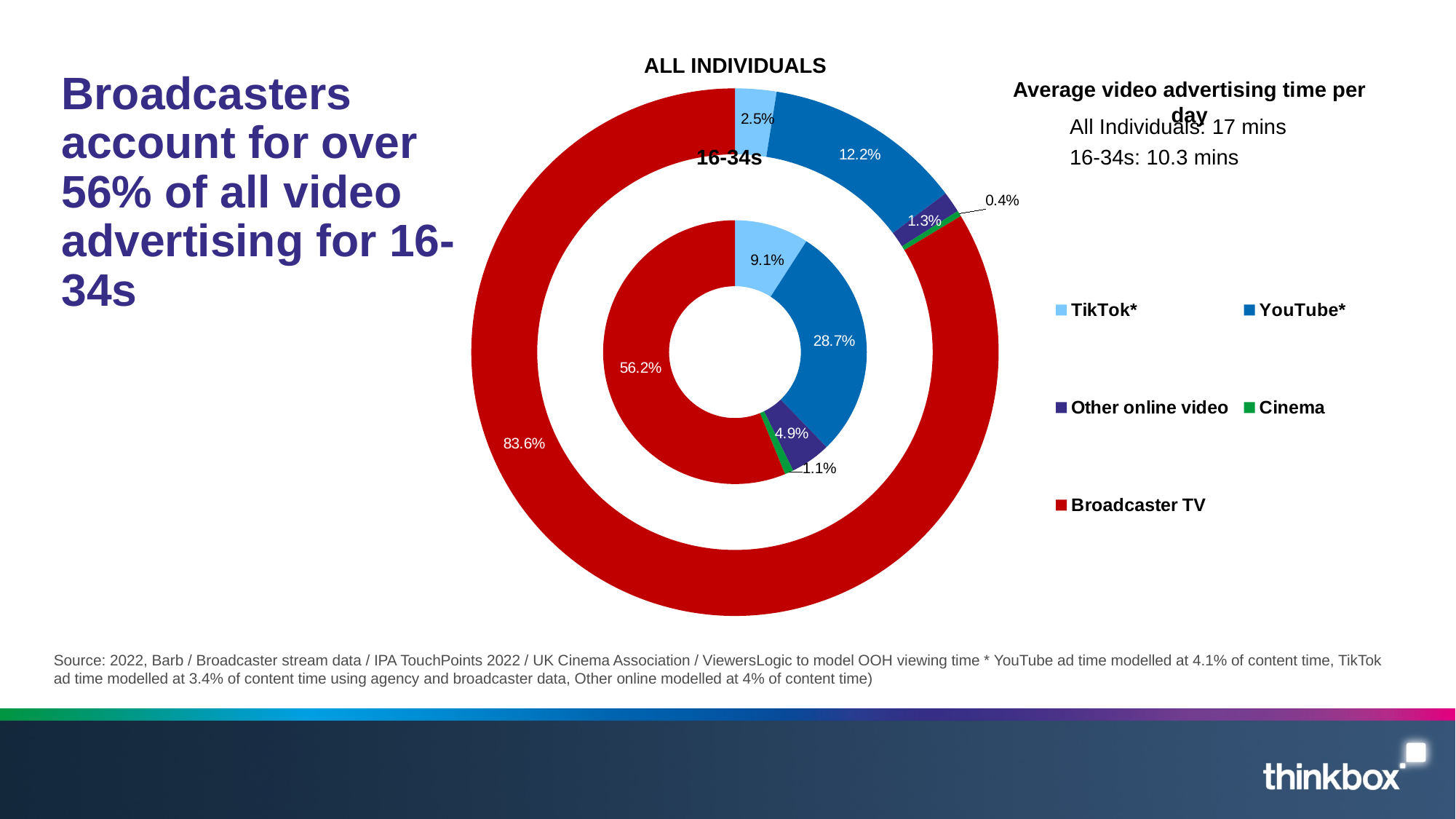
In the doughnut chart, what share does Other online video account for in the ALL INDIVIDUALS ring? 1.3% In the doughnut chart, what is the difference between the Broadcaster TV share for ALL INDIVIDUALS and for 16-34s? 27.4 percentage points In the doughnut chart, what share does YouTube* account for in the 16-34s ring? 28.7% In the doughnut chart, which category has the smallest share in the ALL INDIVIDUALS ring? Cinema In the doughnut chart, which category has the largest share in the 16-34s ring? Broadcaster TV In the doughnut chart, what share does Cinema account for in the 16-34s ring? 1.1% In the doughnut chart, what share does TikTok* account for in the ALL INDIVIDUALS ring? 2.5% What kind of chart is shown on the slide? Doughnut chart In the doughnut chart, what share of video advertising time does Broadcaster TV account for in the ALL INDIVIDUALS ring? 83.6% According to the text beside the chart, what is the average video advertising time per day for 16-34s? 10.3 mins How many series does the legend of the doughnut chart list? 5 In the doughnut chart, which is larger: the TikTok* share for 16-34s or the YouTube* share for ALL INDIVIDUALS? YouTube* share for ALL INDIVIDUALS